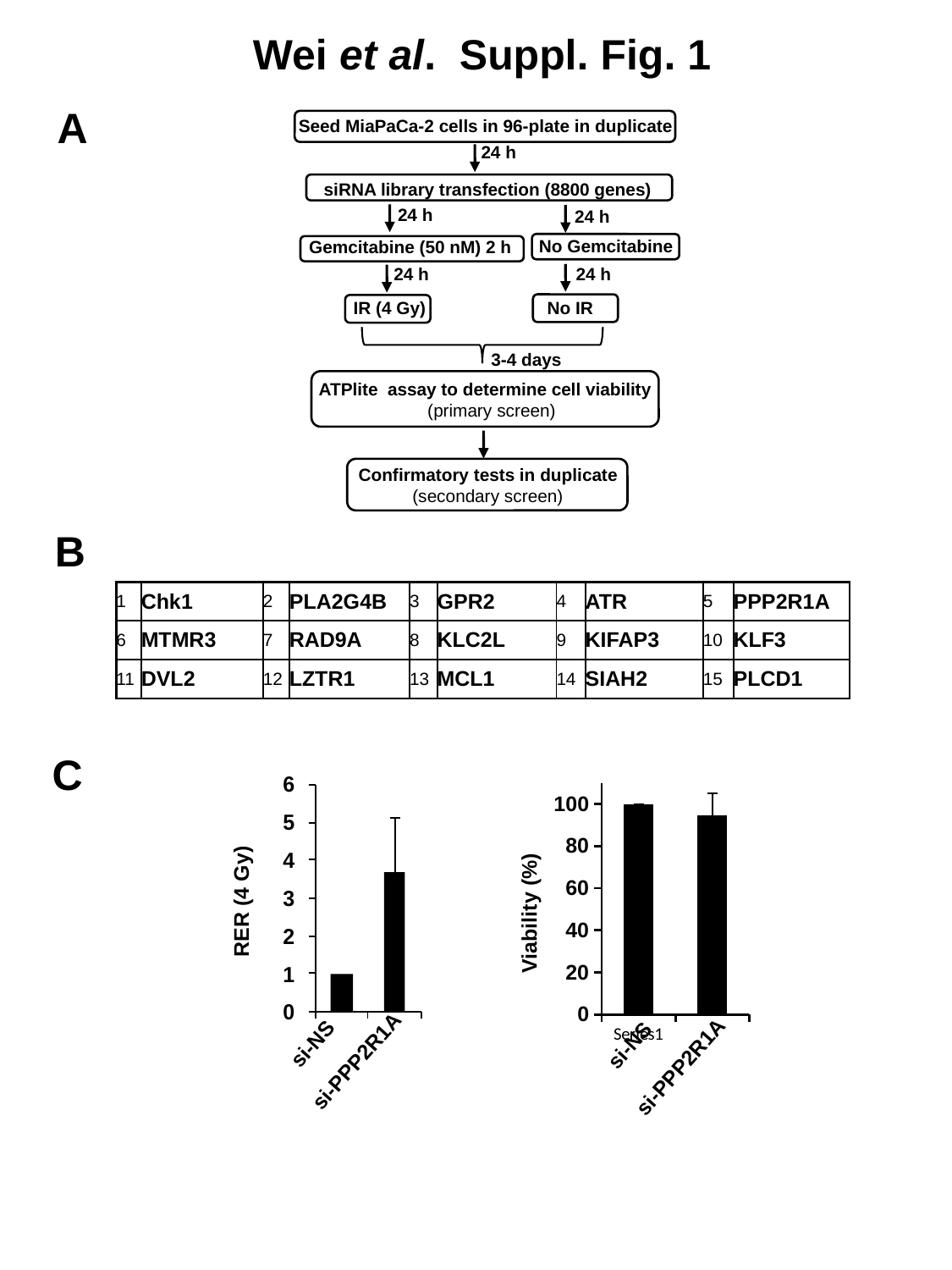
In the left chart of panel C (RER (4 Gy)), how many categories are plotted? 2 In the right chart of panel C (Viability (%)), is the value for si-PPP2R1A greater or less than 80? greater In the left chart of panel C (RER (4 Gy)), what kind of chart is shown? bar chart In the right chart of panel C (Viability (%)), what is the value for si-NS? 100 In the left chart of panel C (RER (4 Gy)), which category has the lowest value? si-NS In the right chart of panel C, what is the y-axis label? Viability (%) In the left chart of panel C (RER (4 Gy)), is the value for si-NS greater or less than 2? less In the right chart of panel C (Viability (%)), how many categories are plotted? 2 In the right chart of panel C (Viability (%)), what kind of chart is shown? bar chart In the left chart of panel C (RER (4 Gy)), which category has the highest value? si-PPP2R1A In the left chart of panel C (RER (4 Gy)), is the value for si-PPP2R1A greater or less than 3? greater In the left chart of panel C, what is the y-axis label? RER (4 Gy)